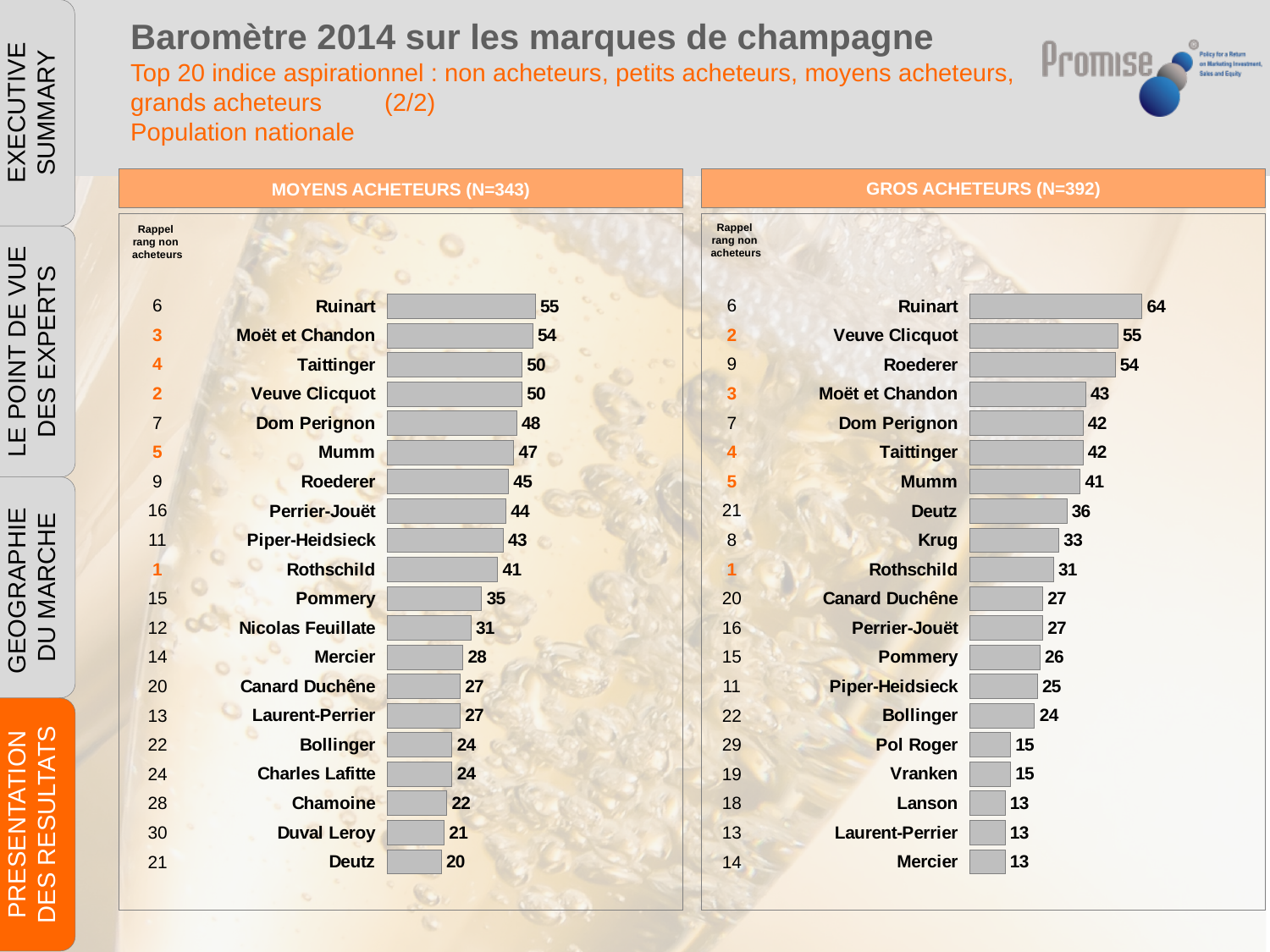
In the GROS ACHETEURS (N=392) chart, what is the difference between the values for Ruinart and Roederer? 10 In the GROS ACHETEURS (N=392) chart, what is the value for Veuve Clicquot? 55 In the GROS ACHETEURS (N=392) chart, which is larger, the value for Deutz or the value for Krug? Deutz What kind of chart is the GROS ACHETEURS (N=392) chart? Bar chart How many brands are shown in the MOYENS ACHETEURS (N=343) chart? 20 In the GROS ACHETEURS (N=392) chart, do the values rise or fall from top to bottom? Fall In the GROS ACHETEURS (N=392) chart, which brand has the highest value? Ruinart In the MOYENS ACHETEURS (N=343) chart, what is the difference between the values for Ruinart and Deutz? 35 In the MOYENS ACHETEURS (N=343) chart, what is the value for Ruinart? 55 In the MOYENS ACHETEURS (N=343) chart, which is larger, the value for Pommery or the value for Mercier? Pommery In the MOYENS ACHETEURS (N=343) chart, which brand has the lowest value? Deutz In the MOYENS ACHETEURS (N=343) chart, what is the value for Nicolas Feuillate? 31